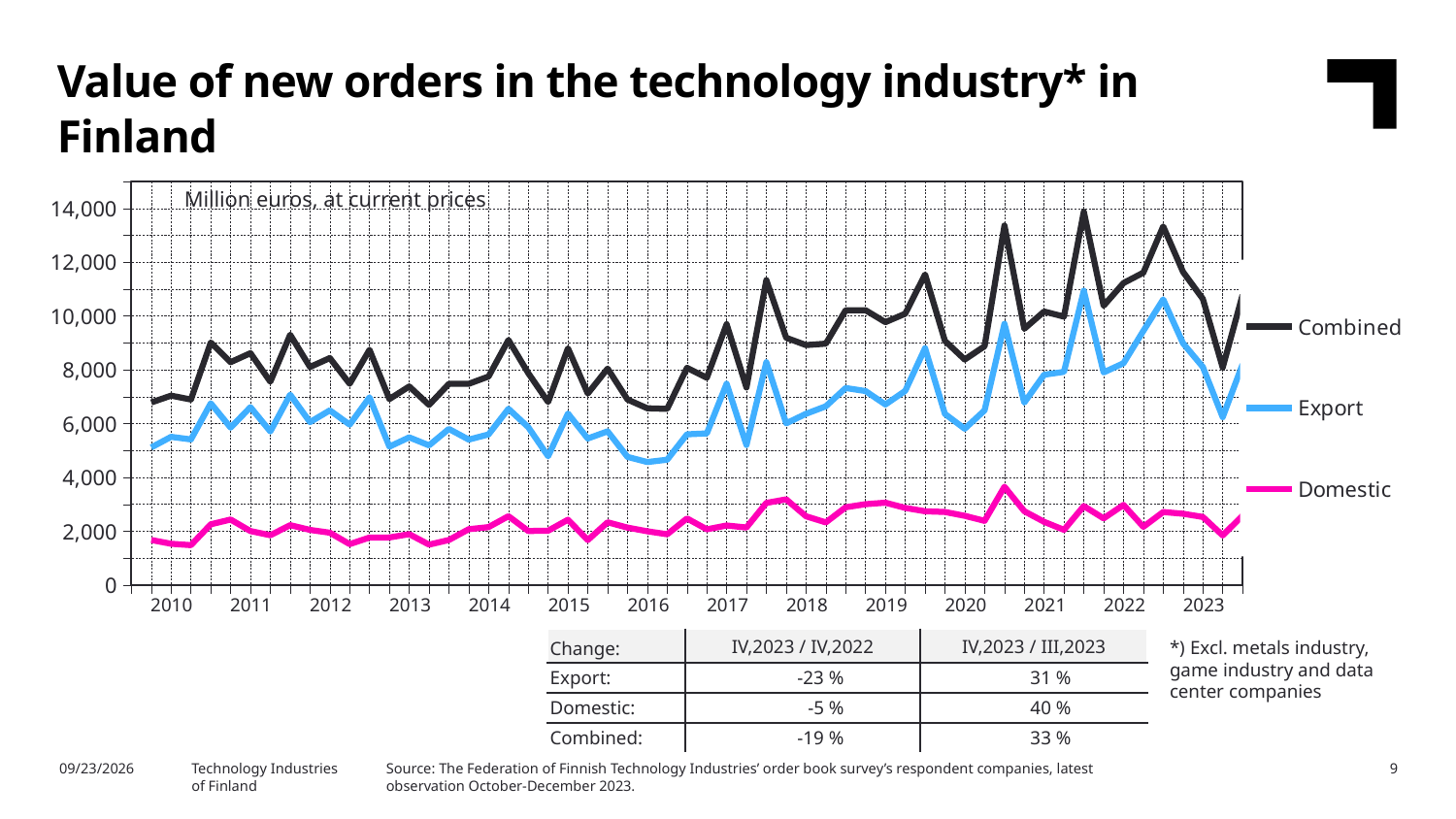
Is the Export value at the start of 2010 greater or less than 6,000? less Which series has the highest values throughout the chart? Combined Is the Combined value at the start of 2010 greater or less than 8,000? less What are the three series named in the chart's legend? Combined, Export, Domestic How many years are labeled on the x axis? 14 How many series does the chart's legend list? 3 Is the peak value of the Combined series in 2021 greater or less than 12,000? greater What unit label is printed inside the chart area? Million euros, at current prices Which series has the lowest values throughout the chart? Domestic Overall, does the Combined series rise or fall from 2010 to 2023? rise What type of chart is shown on the slide? line chart